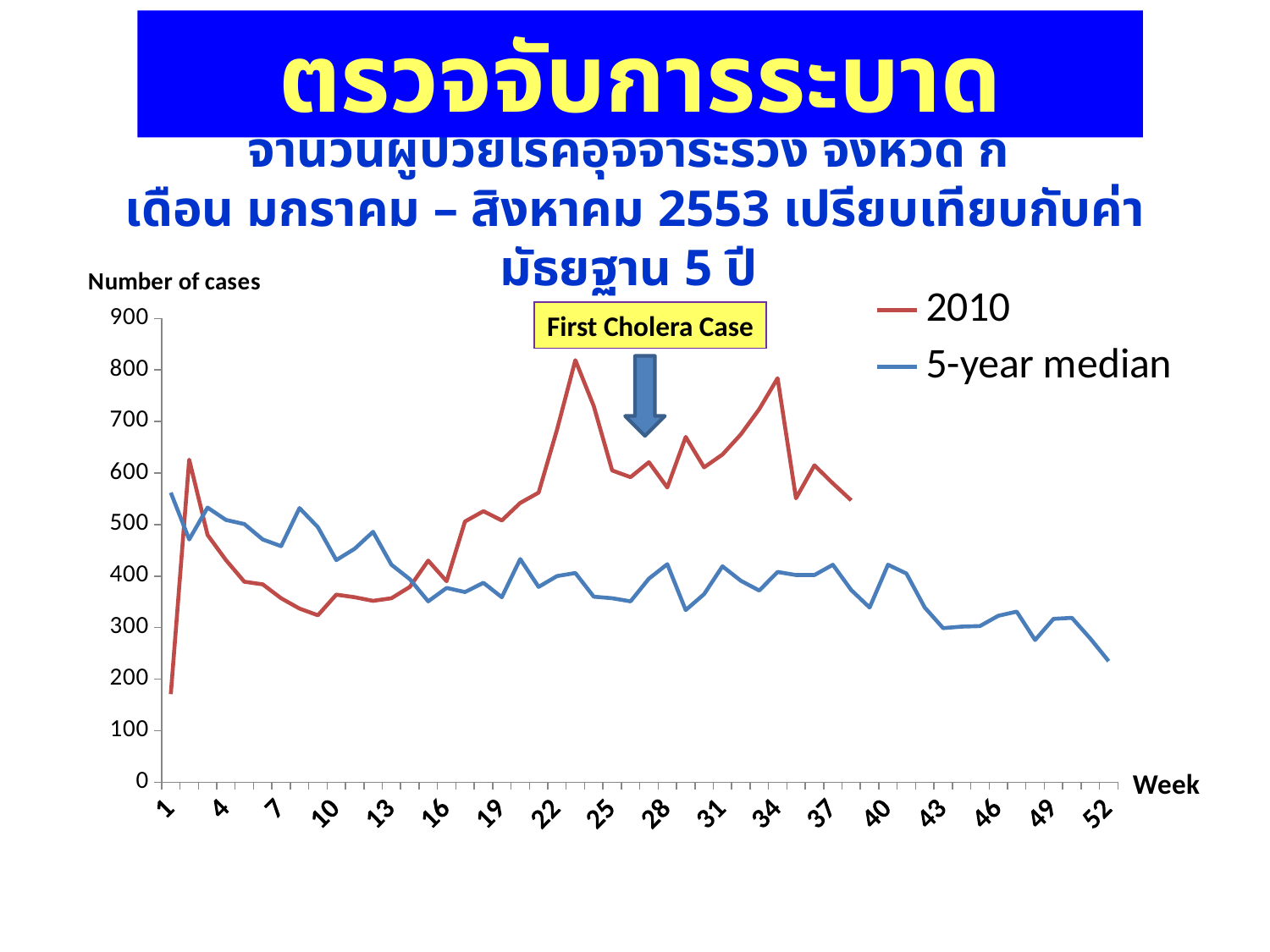
What is the last week shown on the x axis? 52 How many series does the legend list? 2 At week 23, which series has the higher value, 2010 or 5-year median? 2010 Is the value of the 2010 series at week 23 greater or less than 700? greater What are the two series named in the legend? 2010 and 5-year median What kind of chart is shown on the slide? line chart What does the yellow annotation box above the chart say? First Cholera Case Does the 5-year median series generally rise or fall from week 40 to week 52? fall At week 7, which series has the higher value, 2010 or 5-year median? 5-year median Is the value of the 2010 series at week 1 greater or less than 200? less Is the value of the 5-year median series at week 52 greater or less than 300? less